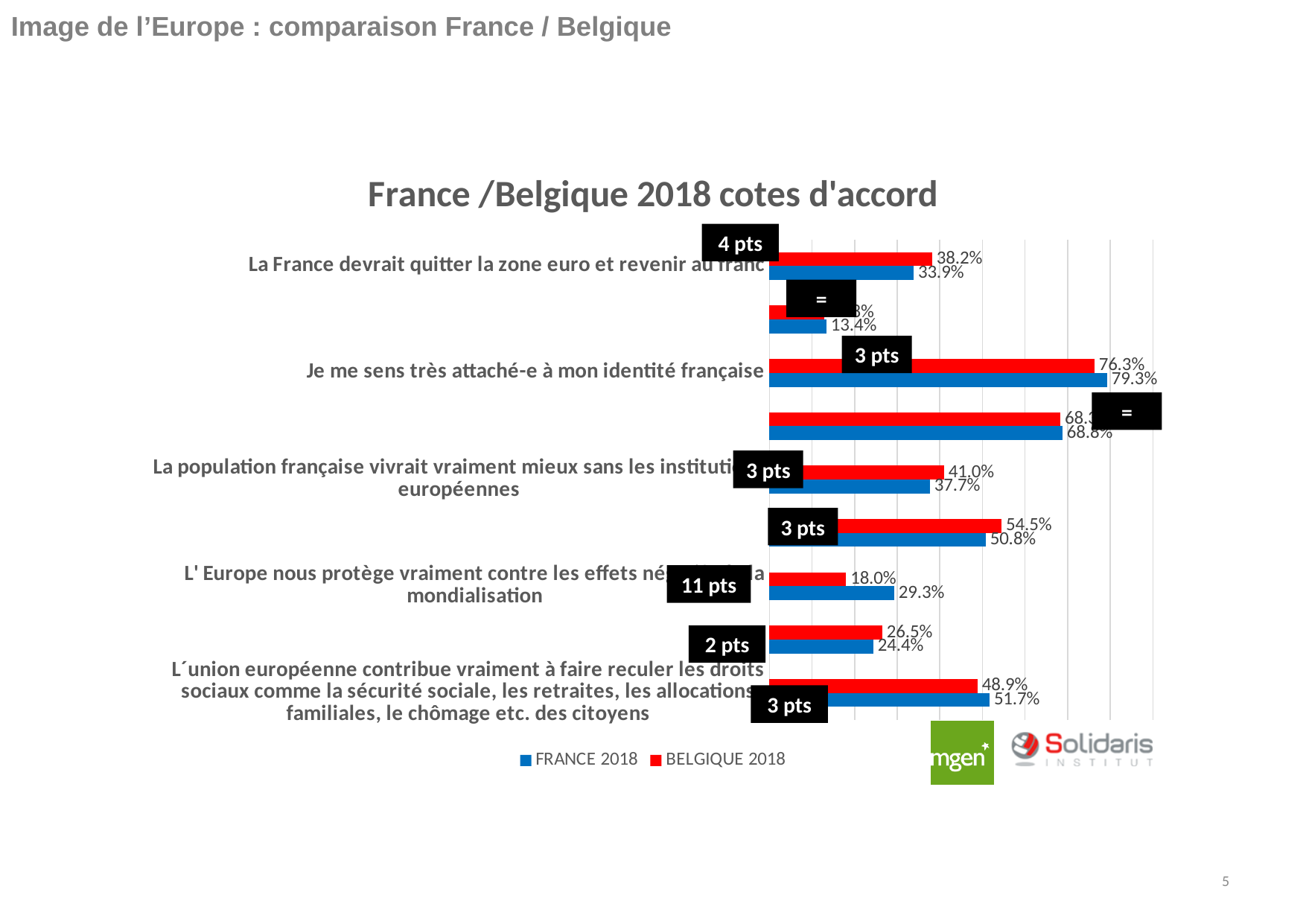
What is the BELGIQUE 2018 value for "La France devrait quitter la zone euro et revenir au franc"? 38.2% How many series does the legend list? 2 For "Je me sens très attaché-e à mon identité française", which series has the larger value, FRANCE 2018 or BELGIQUE 2018? FRANCE 2018 What is the difference in percentage points between the FRANCE 2018 and BELGIQUE 2018 values for the statement beginning "L' Europe nous protège vraiment contre les effets"? 11.3 points What is the FRANCE 2018 value for "Je me sens très attaché-e à mon identité française"? 79.3% What is the BELGIQUE 2018 value for the statement beginning "La population française vivrait vraiment mieux"? 41.0% What is the BELGIQUE 2018 value for the statement beginning "L' Europe nous protège vraiment contre les effets"? 18.0% What is the FRANCE 2018 value for "La France devrait quitter la zone euro et revenir au franc"? 33.9% What kind of chart is shown on the slide? Bar chart What is the FRANCE 2018 value for the statement beginning "L´union européenne contribue vraiment à faire reculer les droits sociaux"? 51.7% What is the BELGIQUE 2018 value for "Je me sens très attaché-e à mon identité française"? 76.3% What is the FRANCE 2018 value for the statement beginning "L' Europe nous protège vraiment contre les effets"? 29.3%